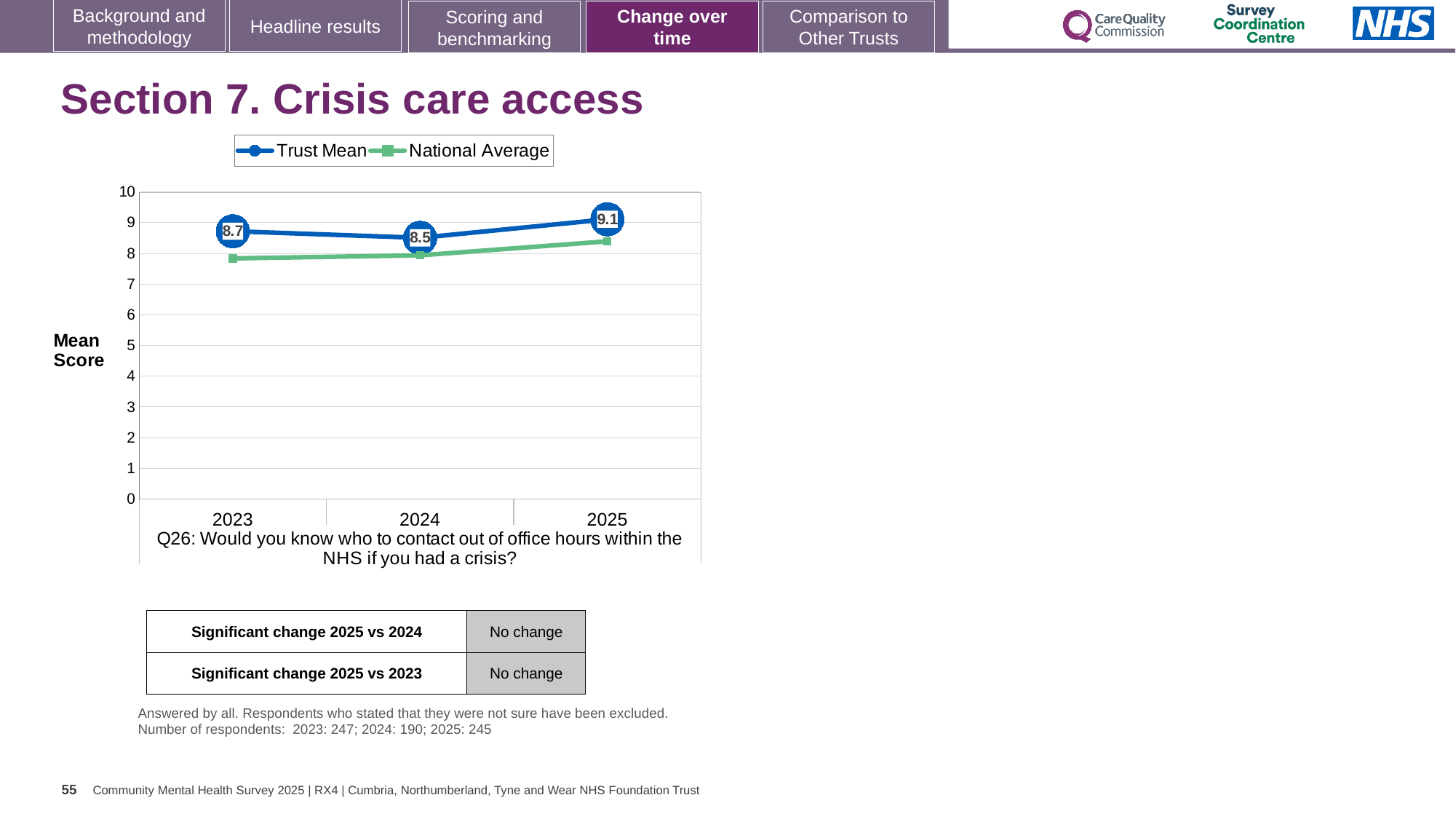
What is the difference between the Trust Mean in 2025 and in 2024? 0.6 Is the National Average for 2023 greater or less than 8? less In which year is the Trust Mean lowest? 2024 How many series does the legend list? 2 What is the Trust Mean score for 2025? 9.1 Is the National Average for 2025 greater or less than 8? greater In which year is the Trust Mean highest? 2025 What is the Trust Mean score for 2024? 8.5 What kind of chart is shown? line chart What is the Trust Mean score for 2023? 8.7 How many years are shown on the x axis? 3 Which is larger, the Trust Mean in 2023 or in 2025? 2025